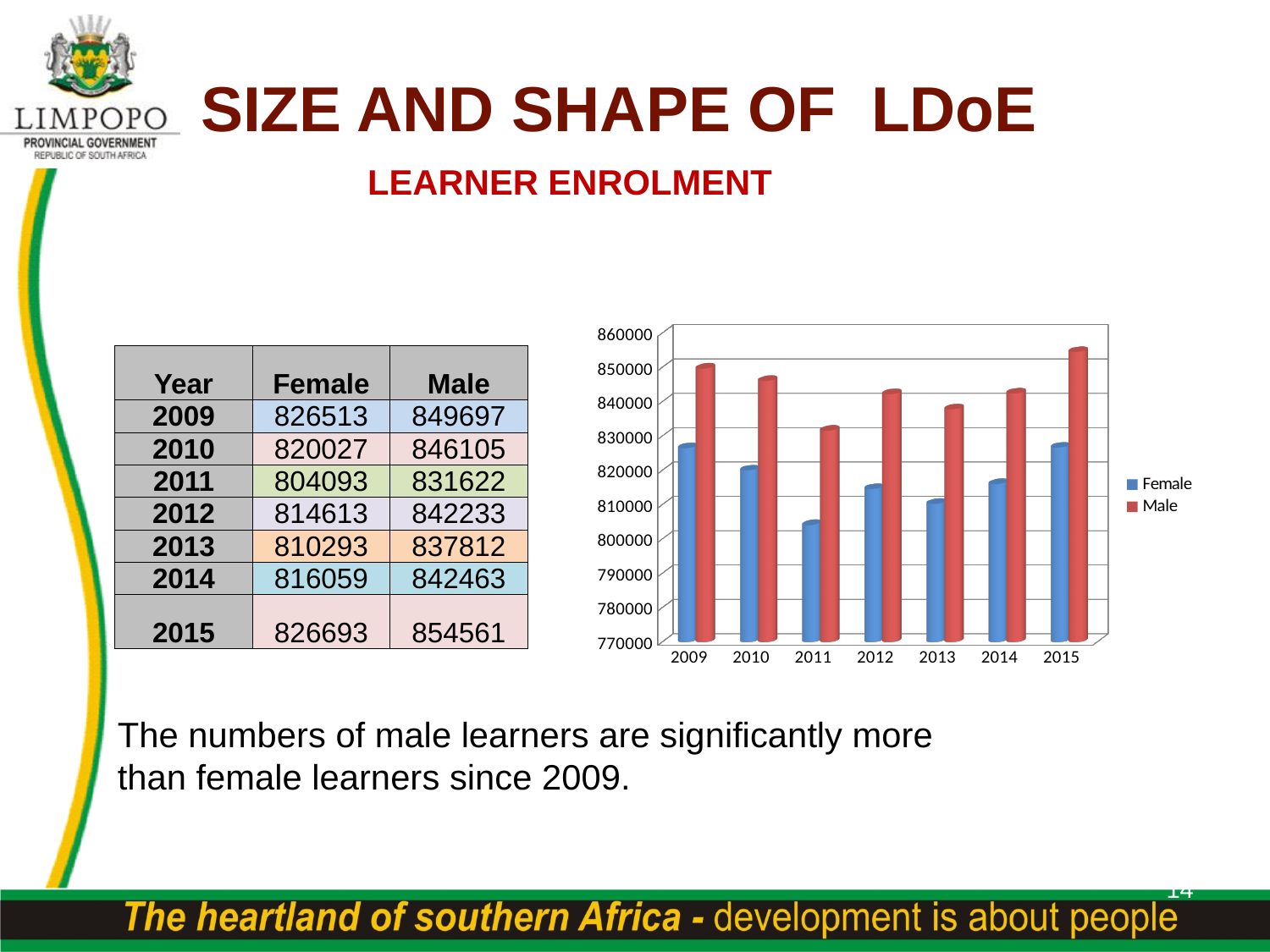
What is the female learner enrolment for 2011? 804093 How many series does the chart legend list? 2 Does male enrolment rise or fall from 2011 to 2015? Rise What kind of chart is shown on the slide? Bar chart What is the difference between male and female enrolment in 2015? 27868 Which year has the highest male enrolment? 2015 Which is larger in 2013, the male or the female enrolment? Male Is the female enrolment for 2011 greater or less than 810000? less What is the male learner enrolment for 2015? 854561 How many years are shown on the x axis of the chart? 7 Is the male enrolment for 2013 greater or less than 830000? greater Which year has the lowest female enrolment? 2011